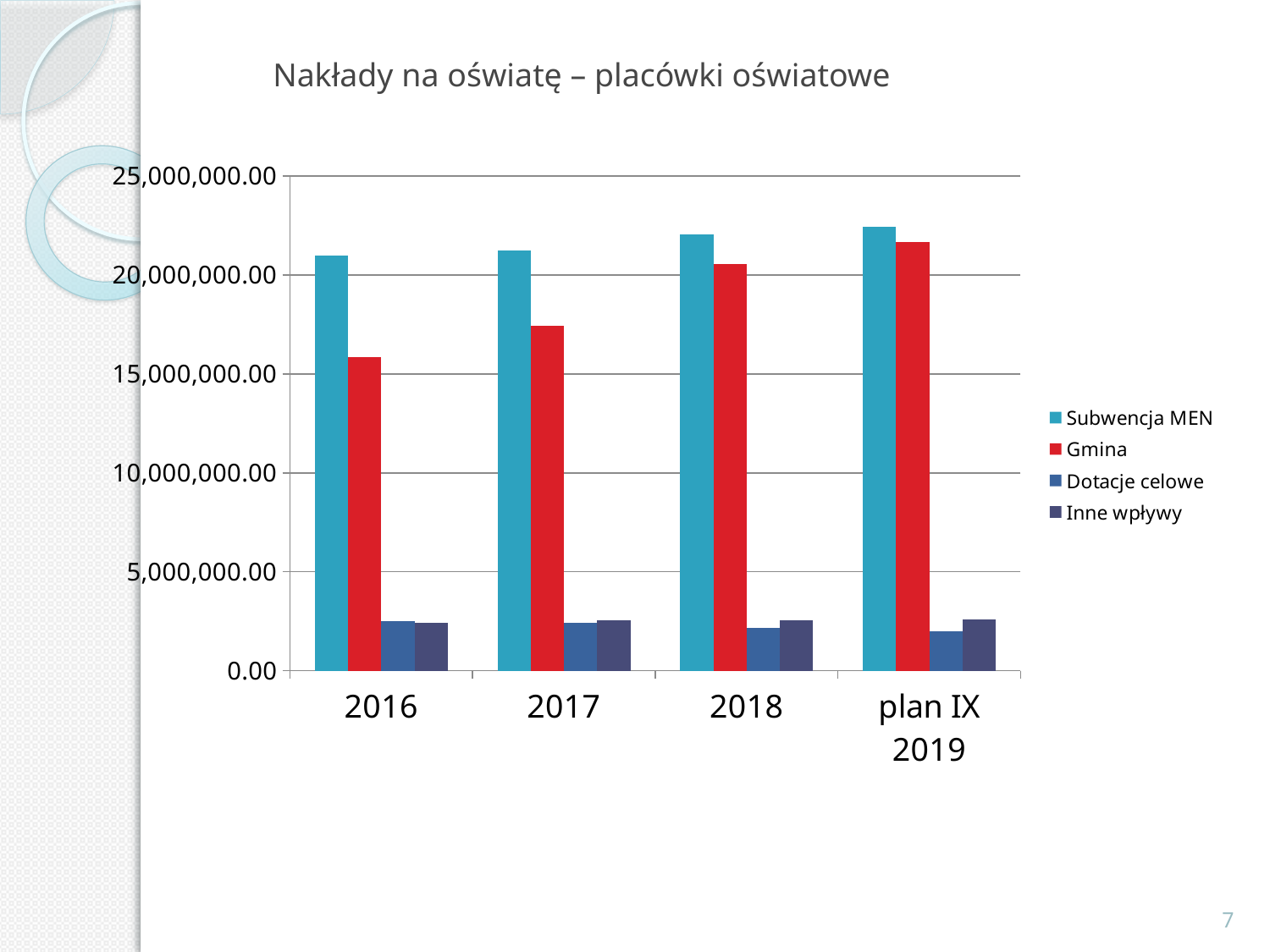
Which is larger in 2017, Subwencja MEN or Gmina? Subwencja MEN What is the title of the slide? Nakłady na oświatę – placówki oświatowe Which series has the highest value in 2016? Subwencja MEN Do the values for Gmina rise or fall from 2016 to plan IX 2019? rise Is the value for Subwencja MEN in 2016 greater or less than 20,000,000.00? greater How many series does the legend list? 4 Is the value for Gmina in 2017 greater or less than 20,000,000.00? less Is the value for Gmina in 2016 greater or less than 15,000,000.00? greater In which category is the value for Gmina the highest? plan IX 2019 In which category is the value for Gmina the lowest? 2016 What kind of chart is shown on the slide? bar chart How many categories are shown on the x axis? 4